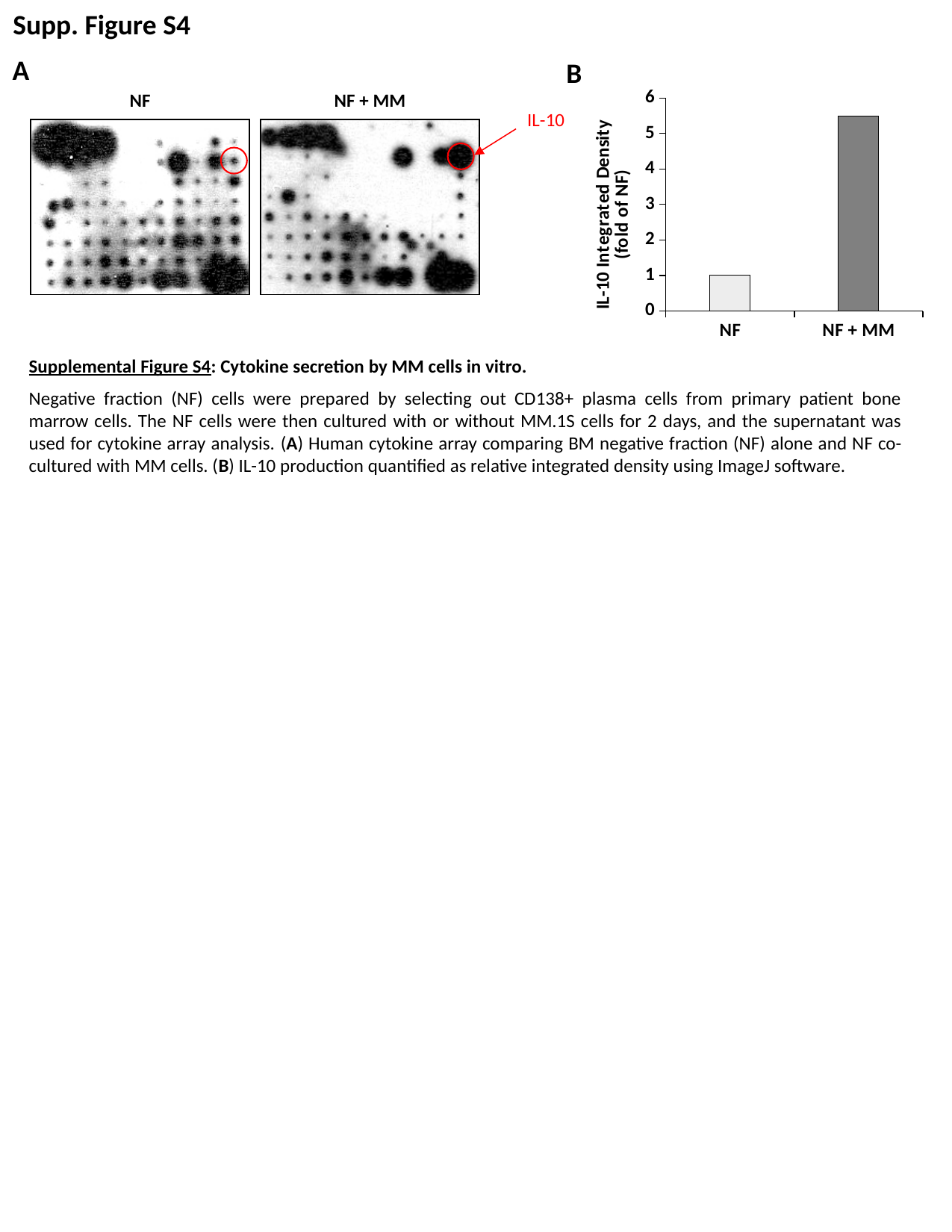
In the bar chart in panel B, which category has the highest IL-10 integrated density? NF + MM In the bar chart in panel B, is the value for NF greater or less than 2? less In the bar chart in panel B, what kind of chart is shown? bar chart In the bar chart in panel B, which category has the lowest IL-10 integrated density? NF In the bar chart in panel B, is the value for NF + MM greater or less than 6? less In the bar chart in panel B, what is the label of the y axis? IL-10 Integrated Density (fold of NF) In the bar chart in panel B, what is the IL-10 integrated density (fold of NF) for NF? 1 In the bar chart in panel B, which is larger, the value for NF or the value for NF + MM? NF + MM In the bar chart in panel B, is the value for NF + MM greater or less than 5? greater In the bar chart in panel B, do the values rise or fall from NF to NF + MM? rise In the bar chart in panel B, what is the maximum value shown on the y axis? 6 In the bar chart in panel B, how many categories are plotted on the x axis? 2